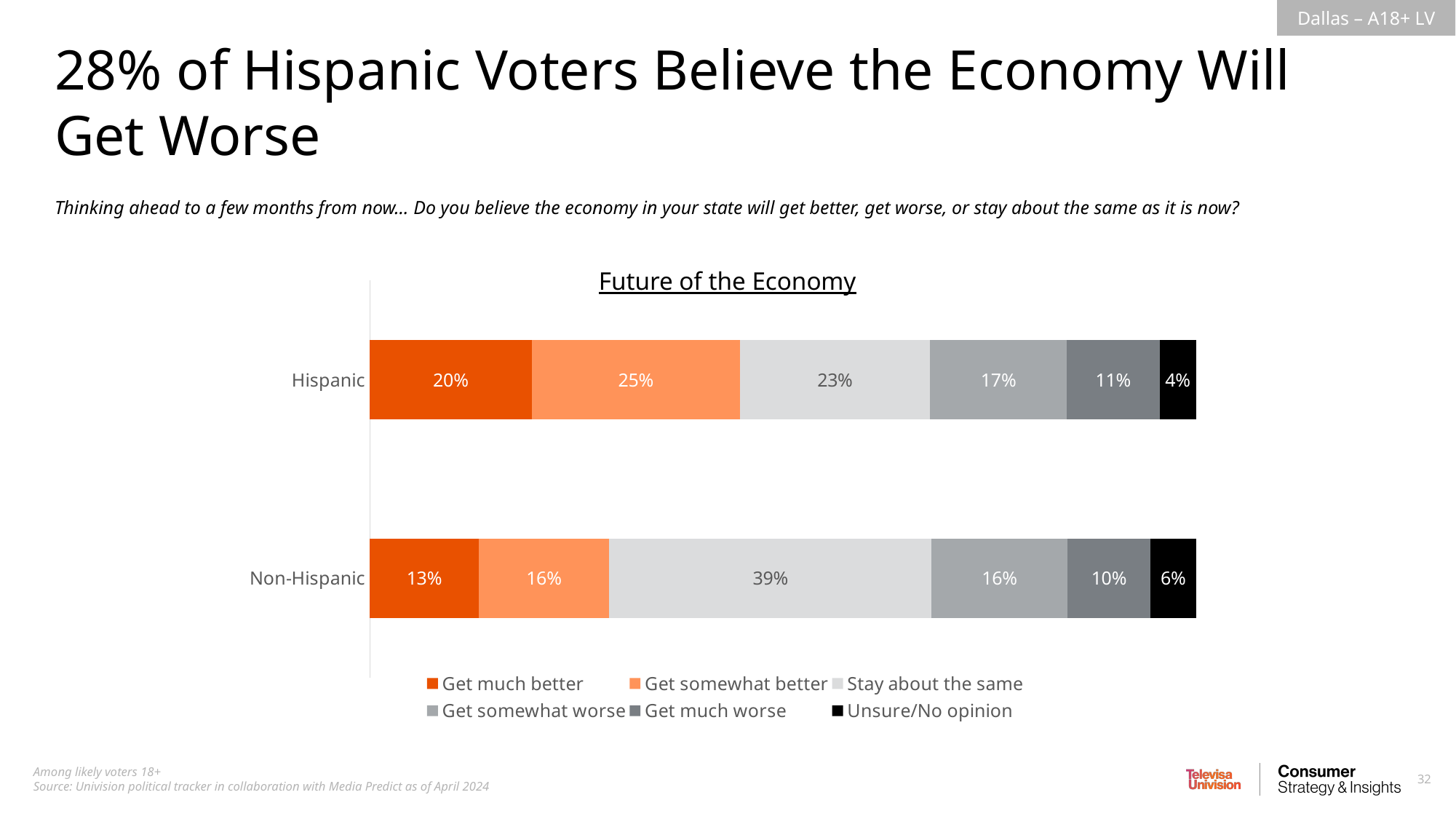
What percentage of Non-Hispanic voters say the economy will stay about the same? 39% How many series does the legend list? 6 What percentage of Hispanic voters say the economy will get much better? 20% What type of chart is shown on the slide? Stacked bar chart What is the combined share of Hispanic voters who say the economy will get somewhat worse or much worse? 28% What percentage of Hispanic voters say the economy will get much worse? 11% Which response has the largest share among Non-Hispanic voters? Stay about the same Which response has the smallest share among Hispanic voters? Unsure/No opinion Which group has a larger share saying the economy will stay about the same, Hispanic or Non-Hispanic? Non-Hispanic What percentage of Non-Hispanic voters are unsure or have no opinion? 6% What is the title of the chart? Future of the Economy What is the difference between the Hispanic and Non-Hispanic shares for 'Get somewhat better'? 9 percentage points